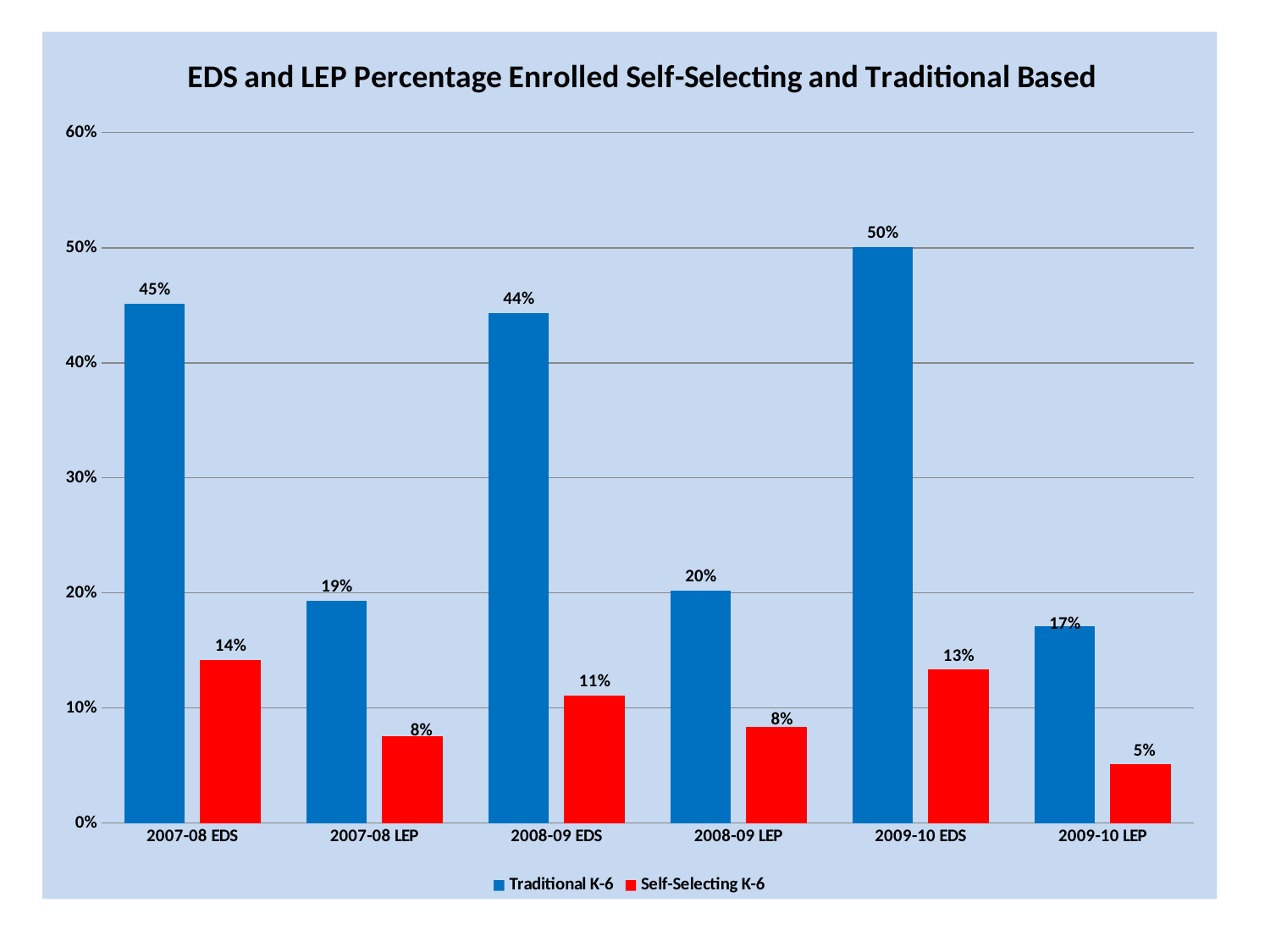
What is the difference between the Traditional K-6 and Self-Selecting K-6 values for 2009-10 EDS? 37% Which category has the highest Traditional K-6 value? 2009-10 EDS Which is larger for 2008-09 LEP: the Traditional K-6 value or the Self-Selecting K-6 value? Traditional K-6 What is the Traditional K-6 value for 2007-08 EDS? 45% What is the Self-Selecting K-6 value for 2008-09 EDS? 11% What is the Self-Selecting K-6 value for 2009-10 LEP? 5% Which category has the lowest Self-Selecting K-6 value? 2009-10 LEP What is the title of the chart? EDS and LEP Percentage Enrolled Self-Selecting and Traditional Based How many series does the legend list? 2 How many categories are shown on the x axis? 6 What kind of chart is shown on the slide? Bar chart